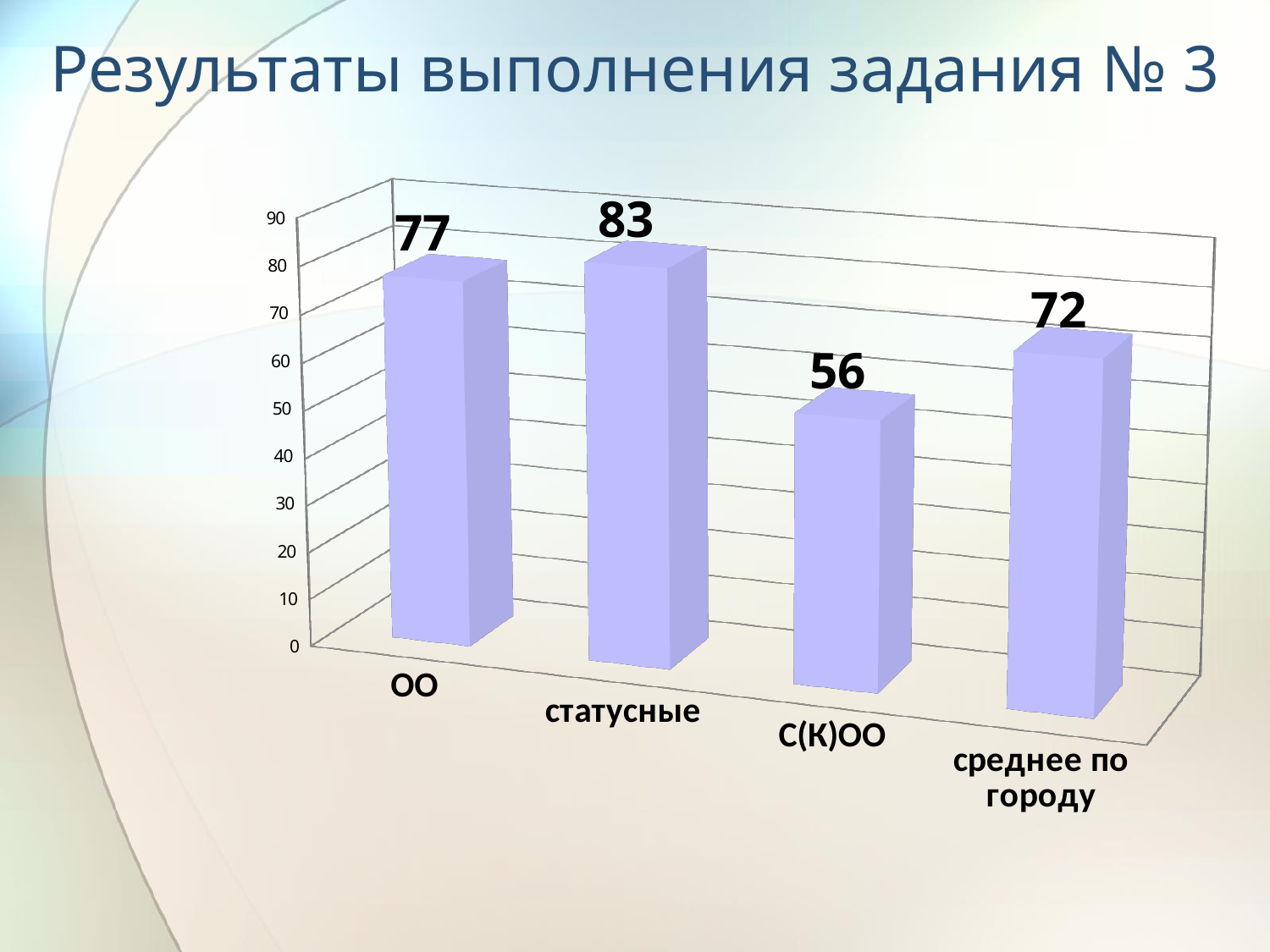
What is the difference between the values for ОО and среднее по городу? 5 Is the value for С(К)ОО greater or less than 60? less Which category has the lowest value? С(К)ОО Which is larger, the value for ОО or the value for среднее по городу? ОО What kind of chart is shown on the slide? bar chart What is the value for статусные? 83 What is the value for среднее по городу? 72 How many categories are shown in the chart? 4 What is the difference between the values for статусные and С(К)ОО? 27 What is the value for ОО? 77 Which category has the highest value? статусные What is the value for С(К)ОО? 56